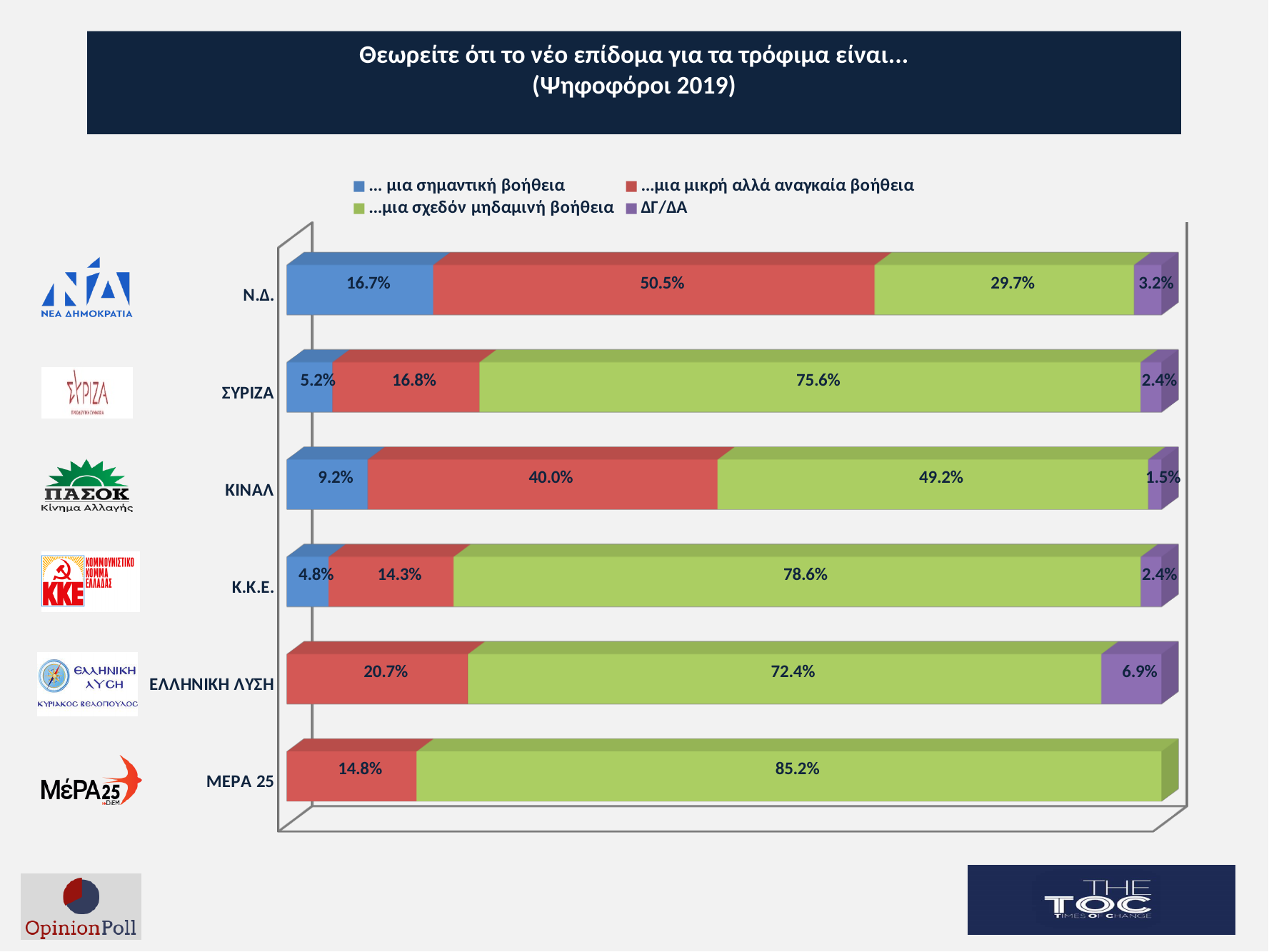
What percentage of Ν.Δ. voters answered "...μια μικρή αλλά αναγκαία βοήθεια"? 50.5% What kind of chart is shown on the slide? Stacked bar chart Which is larger: the "...μια μικρή αλλά αναγκαία βοήθεια" value for ΚΙΝΑΛ or for ΕΛΛΗΝΙΚΗ ΛΥΣΗ? ΚΙΝΑΛ What is the difference between the "...μια σχεδόν μηδαμινή βοήθεια" values for Κ.Κ.Ε. and ΣΥΡΙΖΑ? 3.0% How many parties (categories) are shown in the chart? 6 What is the ΔΓ/ΔΑ value for ΕΛΛΗΝΙΚΗ ΛΥΣΗ? 6.9% Which party has the lowest value for "... μια σημαντική βοήθεια" among those with a value shown? Κ.Κ.Ε. How many series does the legend list? 4 What percentage of ΣΥΡΙΖΑ voters answered "...μια σχεδόν μηδαμινή βοήθεια"? 75.6% What is the value for "... μια σημαντική βοήθεια" for ΚΙΝΑΛ? 9.2% Which colour represents the ΔΓ/ΔΑ series in the chart? Purple Which party has the highest value for "...μια σχεδόν μηδαμινή βοήθεια"? ΜΕΡΑ 25